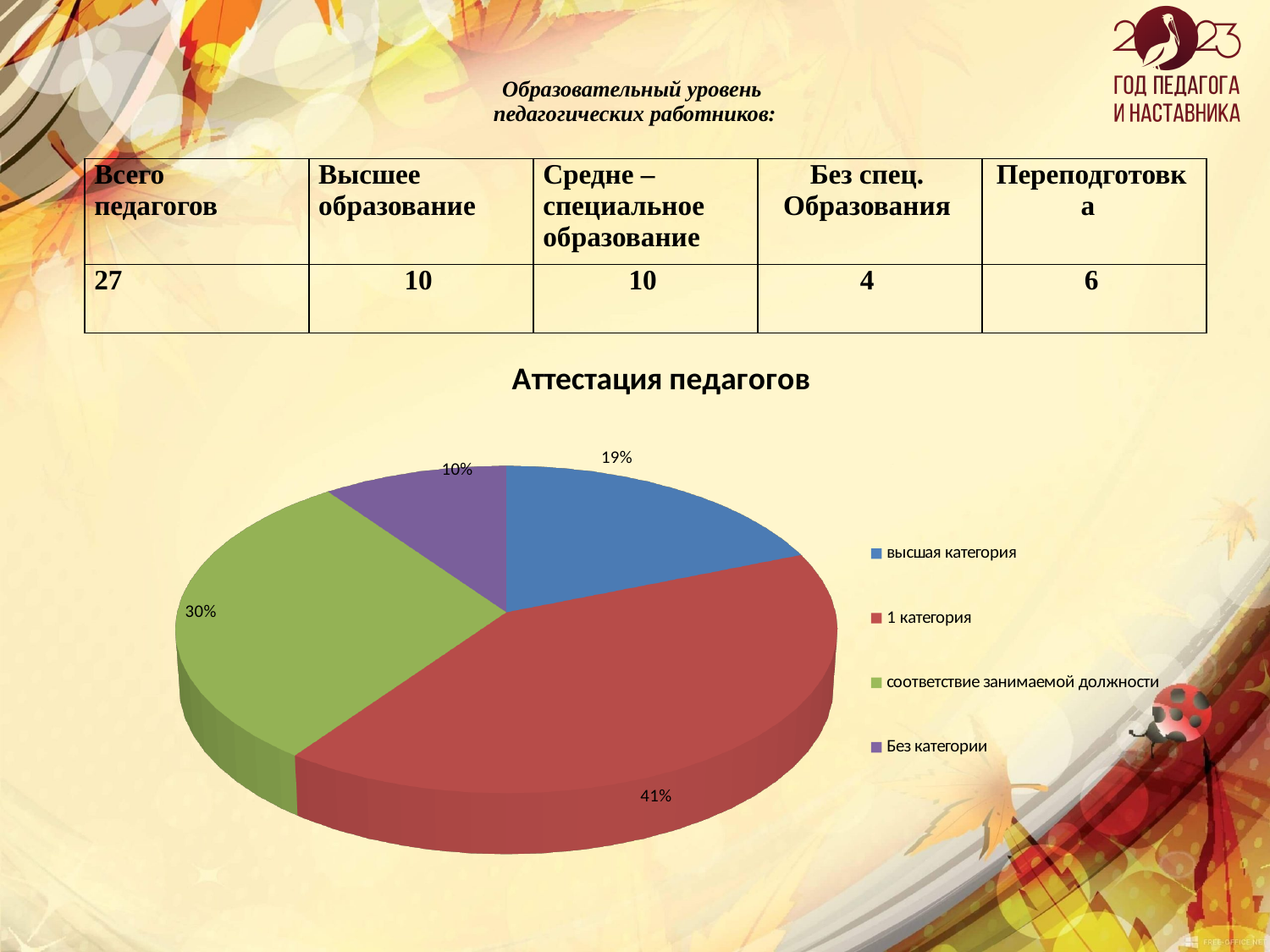
What share of the pie does "соответствие занимаемой должности" have? 30% What type of chart is shown under the title "Аттестация педагогов"? pie chart Which category has the smallest slice of the pie? Без категории What colour is the slice for "соответствие занимаемой должности"? green What is the title of the chart on the slide? Аттестация педагогов What share of the pie does "высшая категория" have? 19% What is the difference in percentage points between "1 категория" and "соответствие занимаемой должности"? 11% Which category has the largest slice of the pie? 1 категория What share of the pie does "1 категория" have? 41% Which is larger: the share for "высшая категория" or the share for "Без категории"? высшая категория How many categories does the legend of the pie chart list? 4